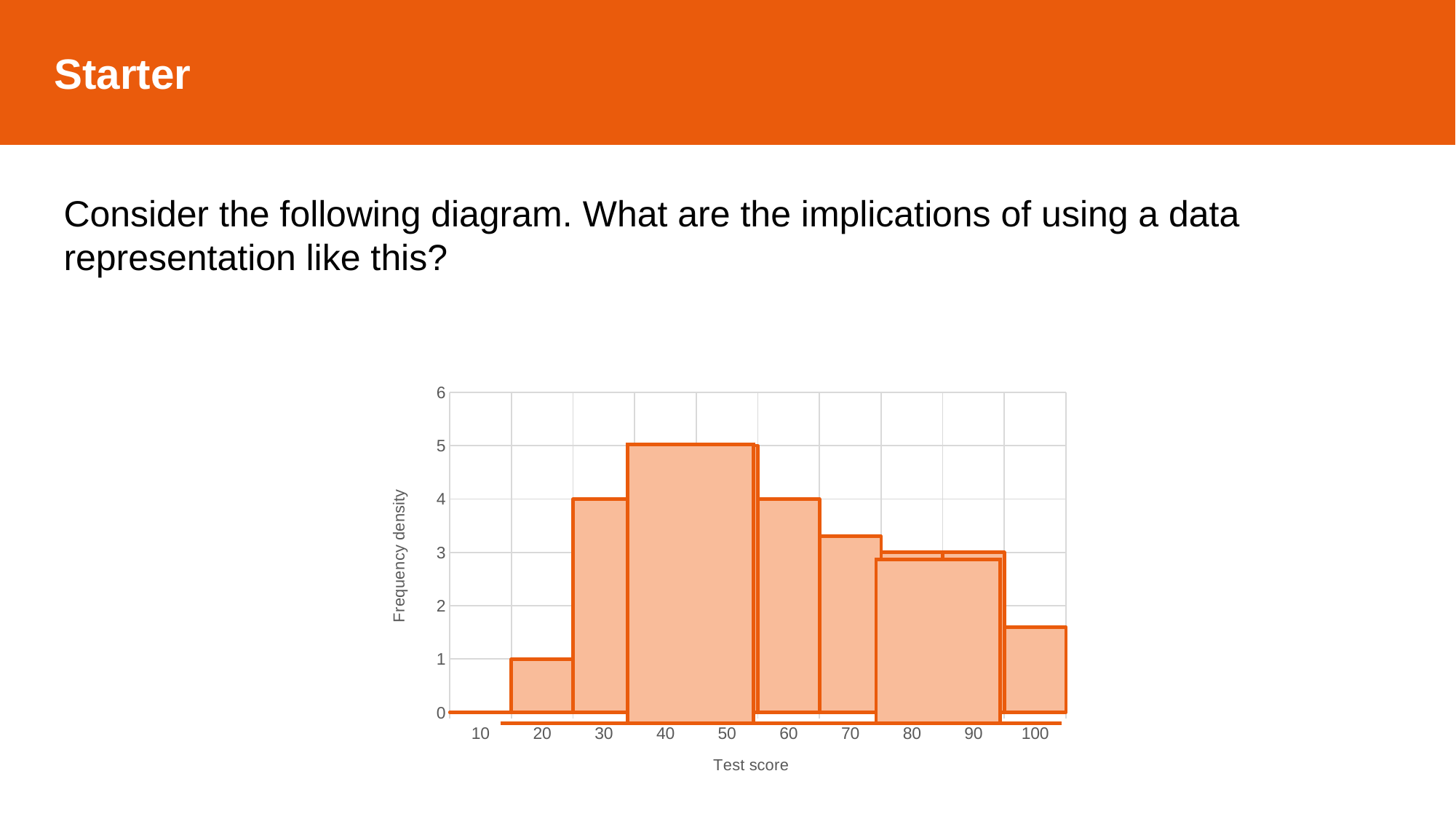
Is the frequency density of the bar spanning test scores 95 to 105 greater or less than 2? less What is the frequency density of the bar spanning test scores 15 to 25? 1 What is the label on the horizontal axis of the chart? Test score What kind of chart is shown on the slide? bar chart (histogram) Which bar has the lowest frequency density? the bar spanning test scores 15 to 25 Which is taller: the bar spanning test scores 25 to 35 or the bar spanning test scores 15 to 25? the bar spanning 25 to 35 What is the frequency density of the tallest bar (test scores 35 to 55)? 5 How many bars are drawn on the chart? 8 What is the label on the vertical axis of the chart? Frequency density Which bar has the highest frequency density? the bar spanning test scores 35 to 55 Is the frequency density of the bar spanning test scores 65 to 75 greater or less than 3? greater What is the frequency density of the bar spanning test scores 25 to 35? 4